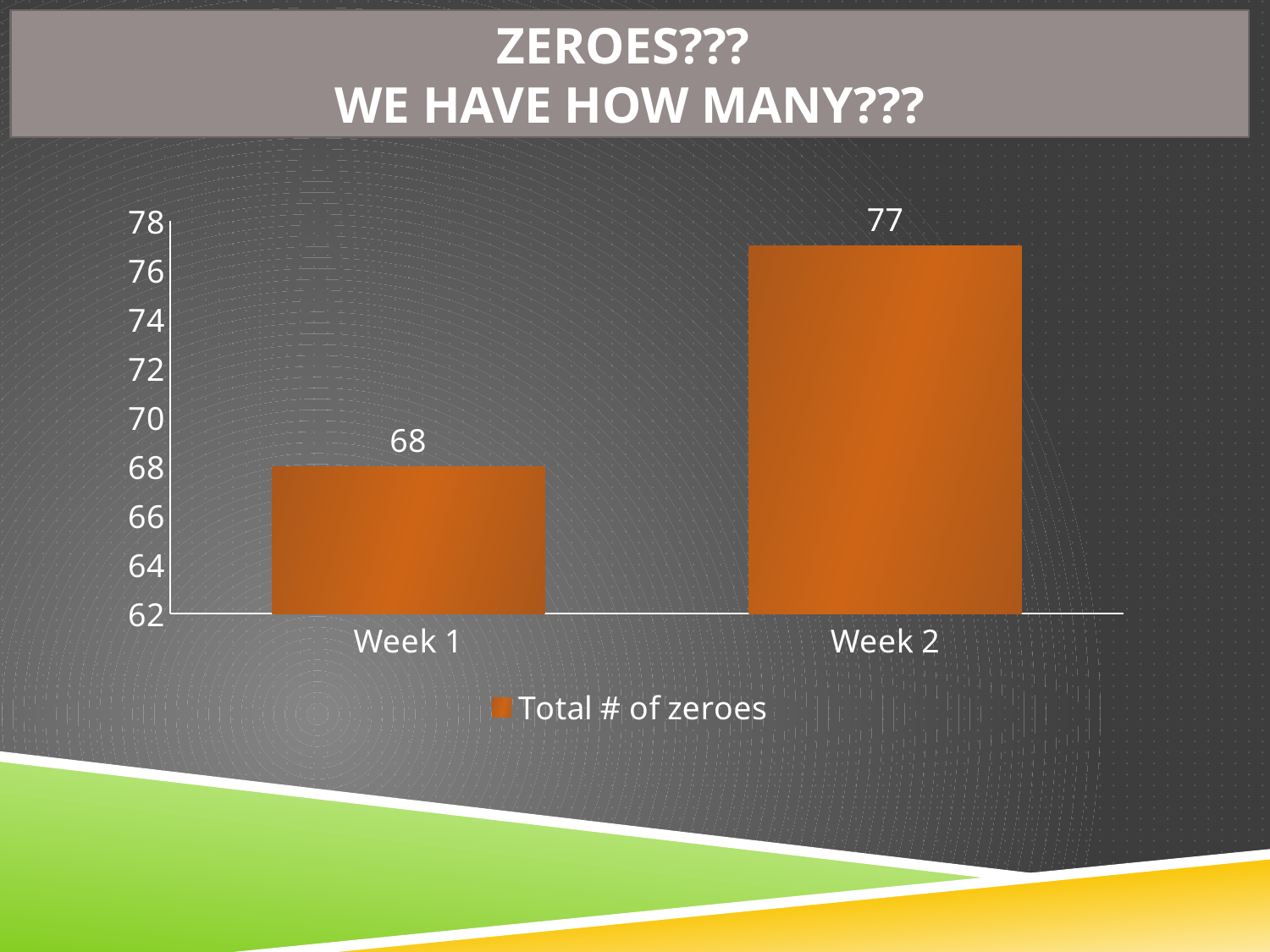
Which is larger, the total number of zeroes in Week 1 or in Week 2? Week 2 What is the total number of zeroes for Week 1? 68 How many categories are shown on the x axis of the chart? 2 What is the difference in the total number of zeroes between Week 2 and Week 1? 9 What kind of chart is shown on the slide? Bar chart How many series does the legend list? 1 Do the values rise or fall from Week 1 to Week 2? Rise Which week has the lowest total number of zeroes? Week 1 Which week has the highest total number of zeroes? Week 2 What is the total number of zeroes for Week 2? 77 Is the value for Week 2 greater or less than 74? greater Is the value for Week 1 greater or less than 70? less